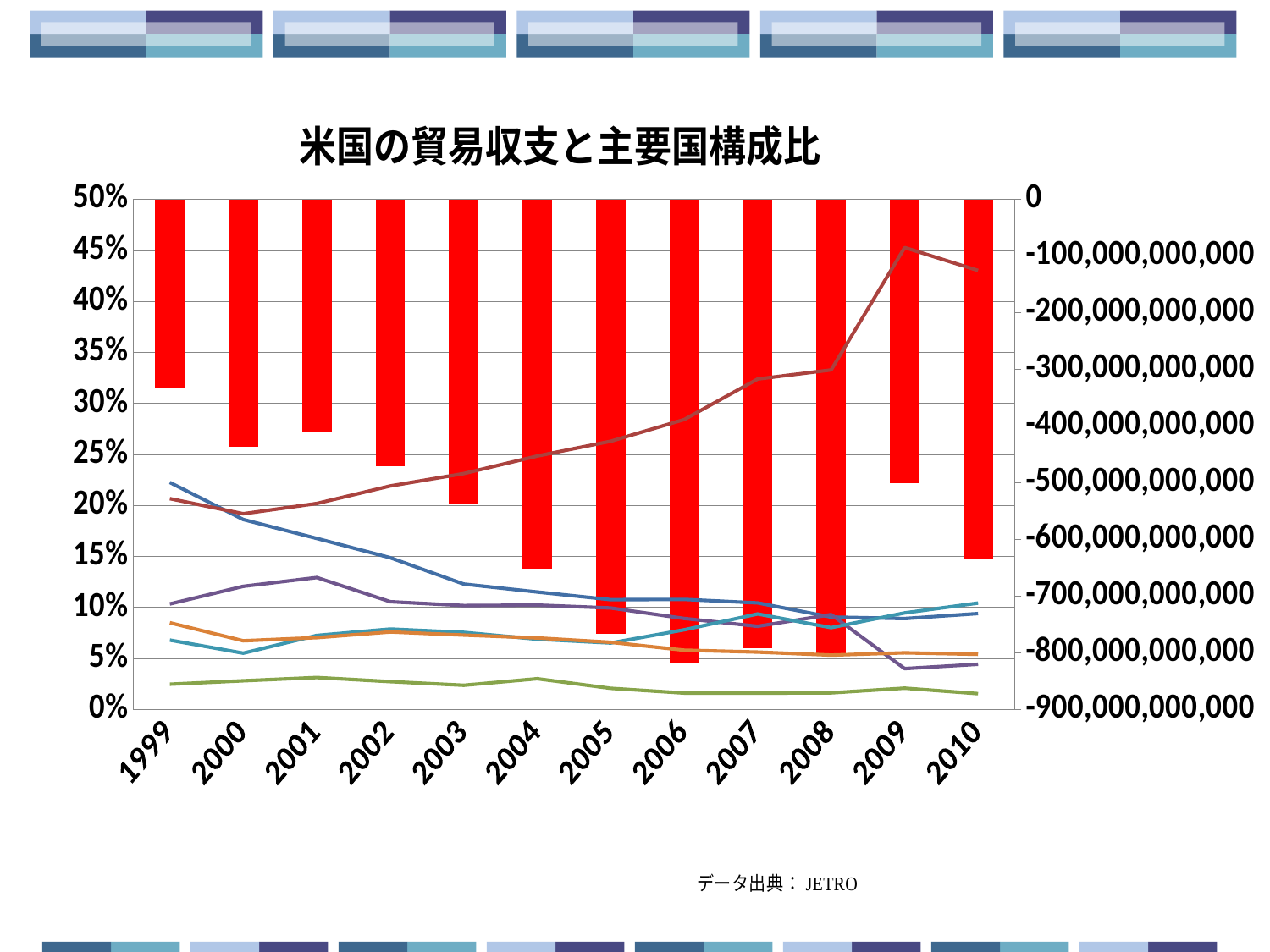
In which year is the red bar the shortest (least negative trade balance)? 1999 What is the last year shown on the x axis? 2010 In which year is the red bar the longest (most negative trade balance)? 2006 Is the value of the red-brown line in 2009 greater or less than 40%? greater In which year does the red-brown line reach its highest value? 2009 What kind of chart is this? Combined bar and line chart How many years are shown on the x axis? 12 Is the value of the dark blue line in 1999 greater or less than 20%? greater Does the red-brown line generally rise or fall from 1999 to 2009? rise How many line series are plotted on the chart? 6 What is the first year shown on the x axis? 1999 What is the title of the chart? 米国の貿易収支と主要国構成比